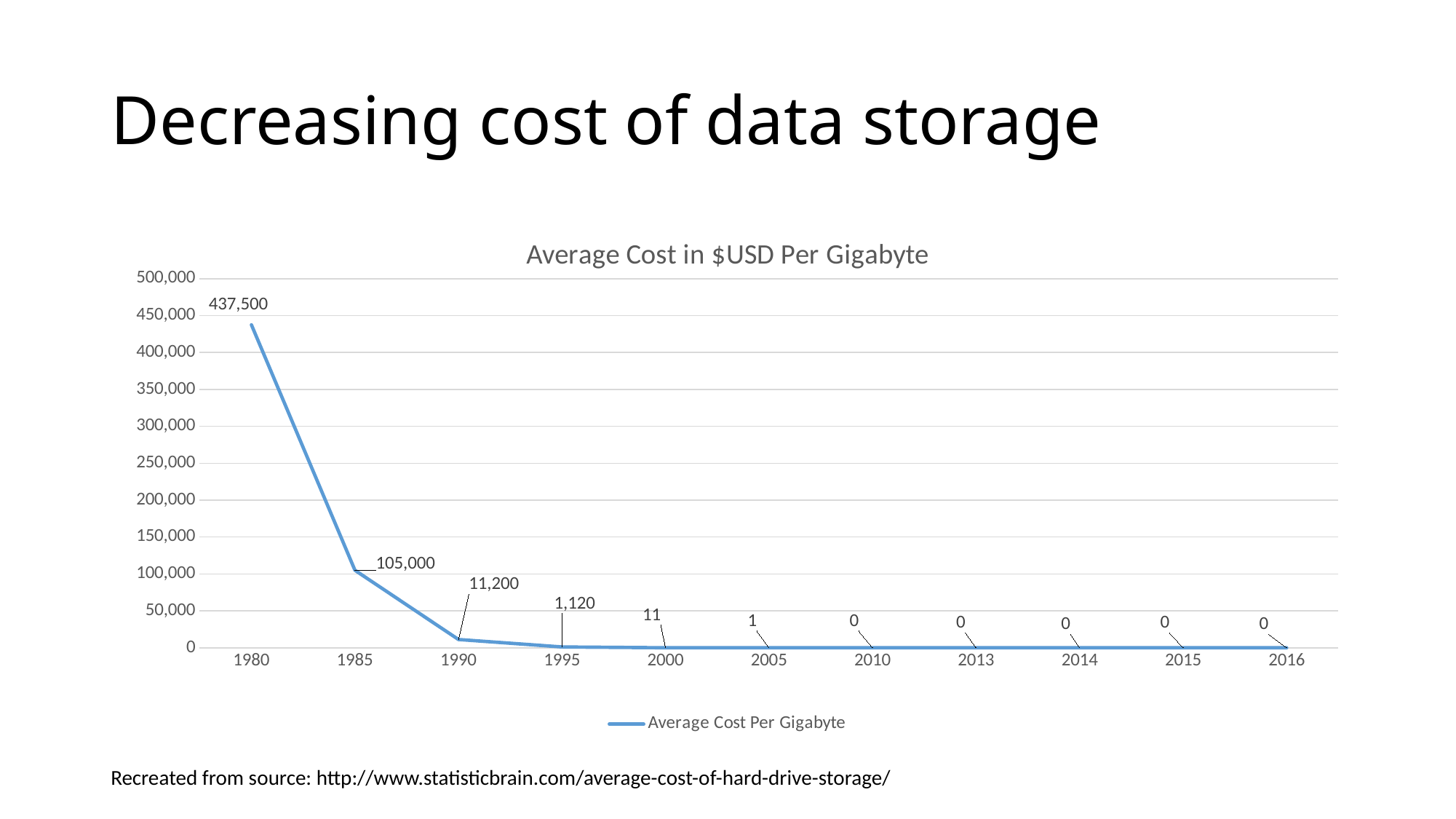
What is the difference between the average cost per gigabyte in 1980 and in 1985? 332,500 What is the average cost per gigabyte in 2000? 11 What is the average cost per gigabyte in 1985? 105,000 What is the average cost per gigabyte in 1980? 437,500 What kind of chart is shown on the slide? line chart Is the value for 1985 greater or less than 150,000? less What is the average cost per gigabyte in 1990? 11,200 What is the average cost per gigabyte in 1995? 1,120 Which year has the highest average cost per gigabyte? 1980 How many years are plotted on the x axis? 11 Do the values rise or fall from 1980 to 2016? fall Which is larger, the average cost per gigabyte in 1990 or in 1995? 1990